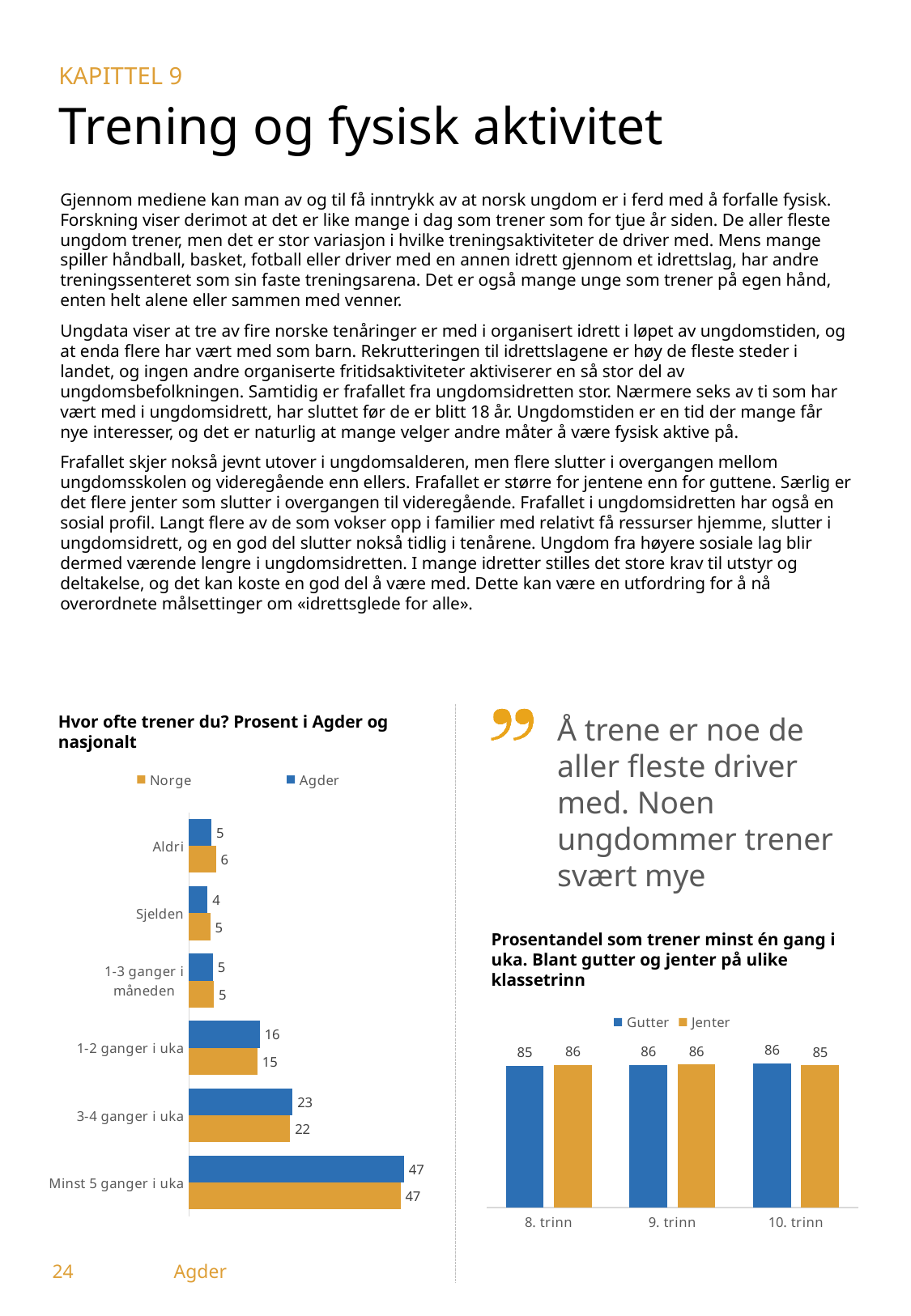
In the chart 'Prosentandel som trener minst én gang i uka', what is the value for Gutter in 10. trinn? 86 In the chart 'Hvor ofte trener du? Prosent i Agder og nasjonalt', what is the value for Agder for 'Minst 5 ganger i uka'? 47 In the chart 'Hvor ofte trener du? Prosent i Agder og nasjonalt', what is the value for Norge for '3-4 ganger i uka'? 22 In the chart 'Hvor ofte trener du? Prosent i Agder og nasjonalt', what is the difference between the Agder and Norge values for '1-2 ganger i uka'? 1 In the chart 'Prosentandel som trener minst én gang i uka', how many class levels (categories) are shown? 3 In the chart 'Prosentandel som trener minst én gang i uka', what is the value for Jenter in 8. trinn? 86 In the chart 'Hvor ofte trener du? Prosent i Agder og nasjonalt', how many series does the legend list? 2 In the chart 'Hvor ofte trener du? Prosent i Agder og nasjonalt', which category has the highest value for Agder? Minst 5 ganger i uka What kind of chart is 'Hvor ofte trener du? Prosent i Agder og nasjonalt'? Bar chart In the chart 'Hvor ofte trener du? Prosent i Agder og nasjonalt', how many categories are shown? 6 In the chart 'Prosentandel som trener minst én gang i uka', which colour represents Jenter? Orange In the chart 'Hvor ofte trener du? Prosent i Agder og nasjonalt', which category has the lowest value for Agder? Sjelden